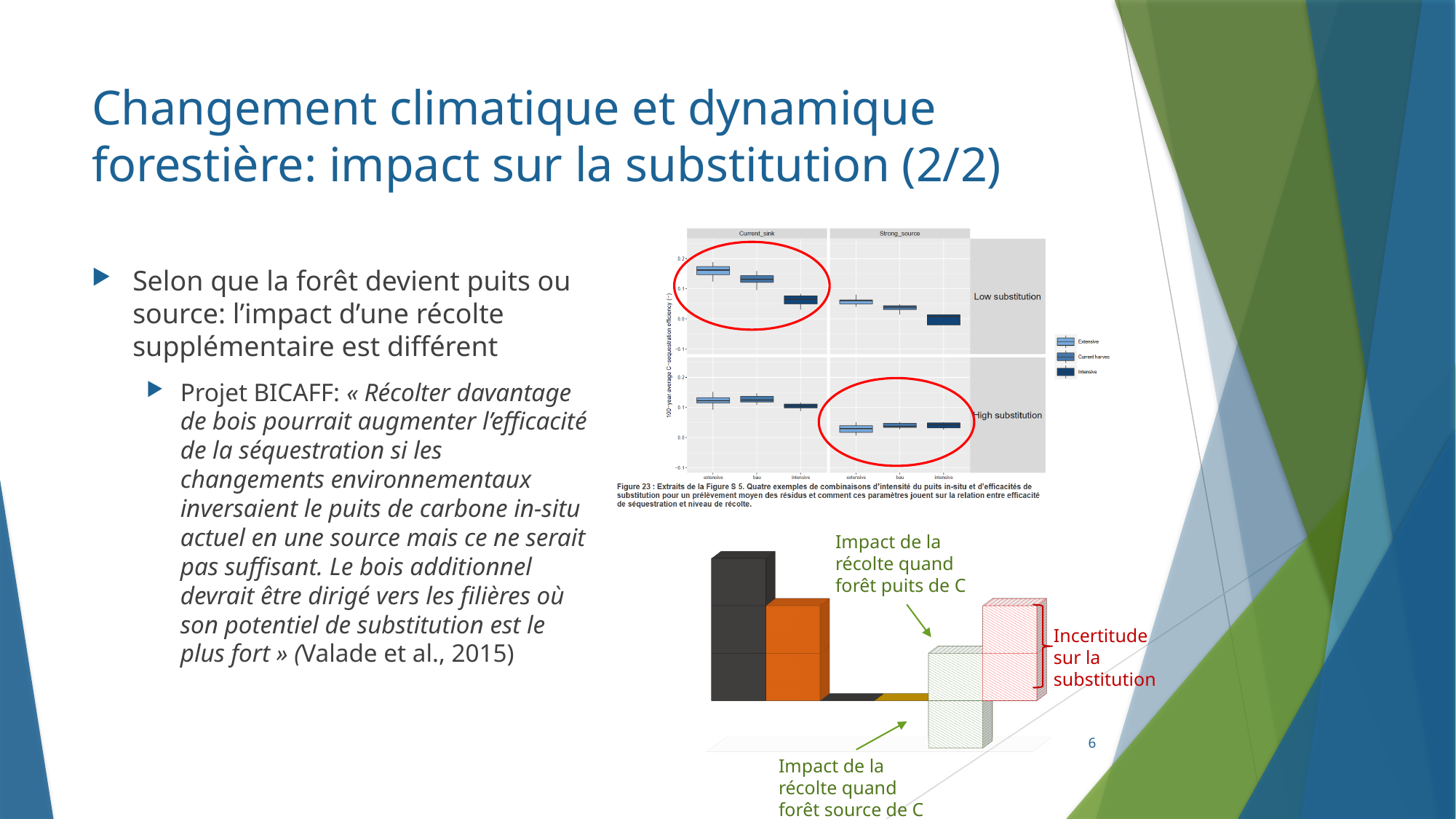
In the box plot figure, how many entries does the legend list? 3 In the box plot figure, Current_sink / Low substitution panel, which is larger, the value for extensive or for intensive? extensive In the box plot figure, Strong_source / High substitution panel, is the value for extensive greater or less than 0.1? less In the box plot figure, Current_sink / Low substitution panel, do the values rise or fall from extensive to intensive? fall In the box plot figure, how many categories are shown on the x axis of each panel? 3 In the box plot figure, what are the titles of the two panel columns? Current_sink and Strong_source In the box plot figure, Strong_source / Low substitution panel, which category has the lowest value? intensive In the box plot figure, Current_sink / High substitution panel, is the value for intensive greater or less than 0.2? less In the box plot figure, Current_sink / Low substitution panel, which category has the highest value? extensive In the box plot figure, Current_sink / Low substitution panel, is the value for extensive greater or less than 0.1? greater What kind of chart is the figure at the top right of the slide (Figure 23)? box plot In the box plot figure, what are the three legend entries? Extensive, Current harves, Intensive